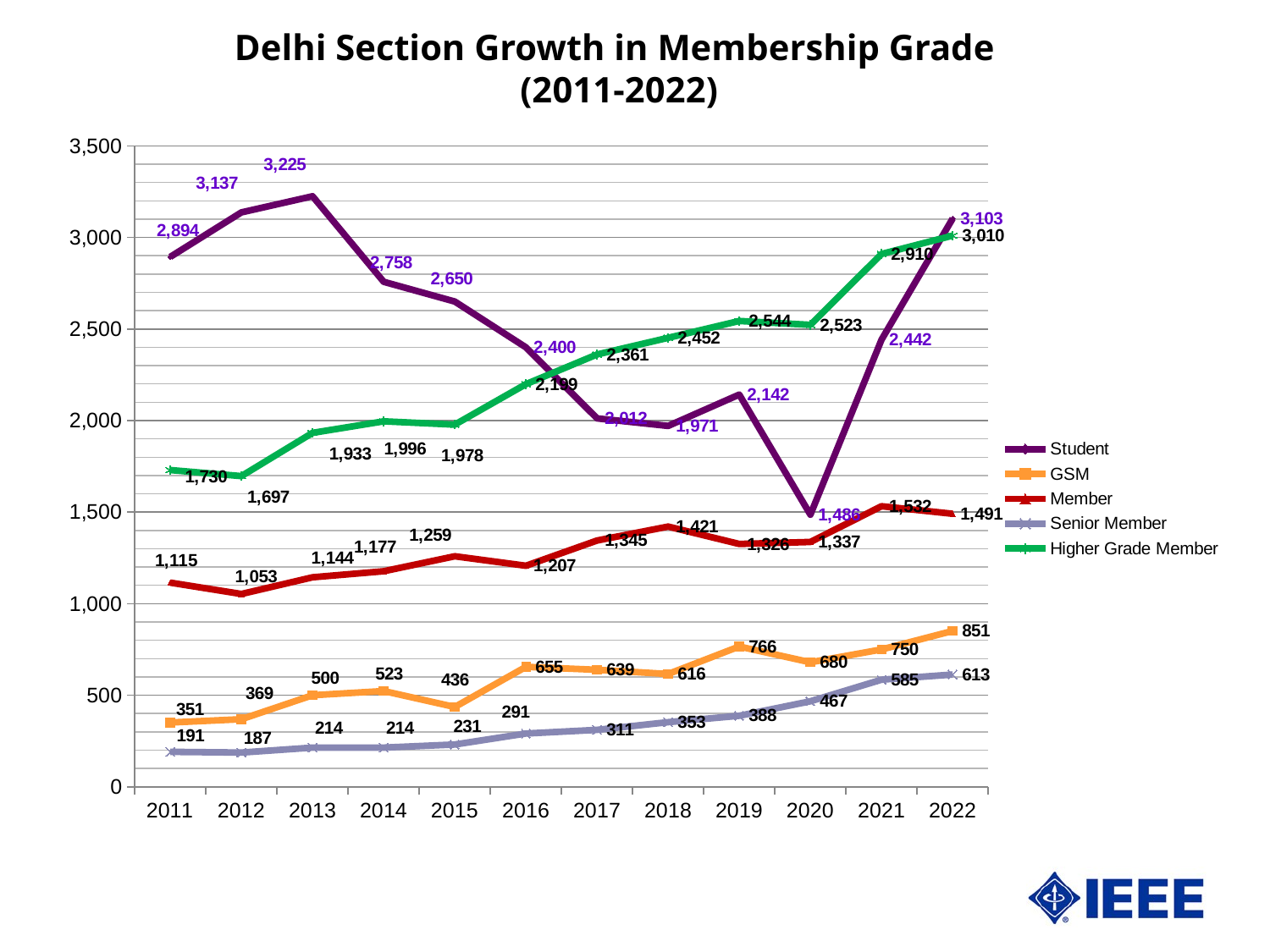
What was the Student membership value in 2013? 3,225 Which was larger in 2017: the Higher Grade Member value or the Student value? Higher Grade Member What was the GSM value in 2019? 766 What is the difference between the Member values in 2021 and 2011? 417 What was the Higher Grade Member value in 2022? 3,010 What kind of chart is shown on the slide? Line chart What was the Senior Member value in 2021? 585 In which year was the Student series at its lowest? 2020 Does the Senior Member series rise or fall from 2015 to 2022? Rise How many series does the legend list? 5 How many years are plotted along the x axis? 12 In which year was the GSM series at its highest? 2022